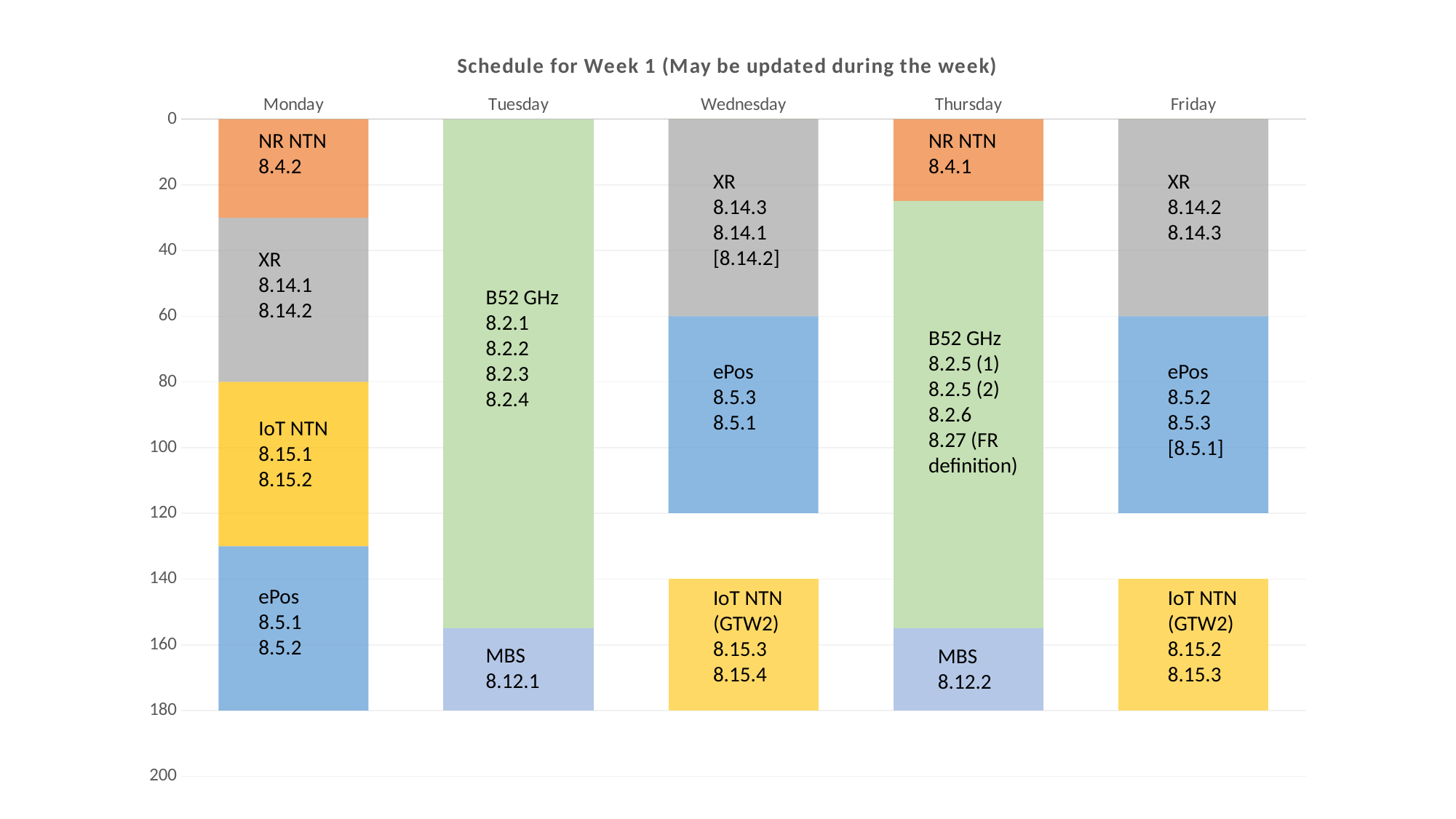
On which day is the NR NTN block labelled 8.4.1? Thursday On which day does the MBS block contain item 8.12.2? Thursday Which agenda item is listed in the NR NTN block on Monday? 8.4.2 On which days does an IoT NTN (GTW2) block appear? Wednesday and Friday What is the title of the chart? Schedule for Week 1 (May be updated during the week) Which agenda items are listed in the B52 GHz block on Tuesday? 8.2.1, 8.2.2, 8.2.3, 8.2.4 Which topic is at the top of the Tuesday bar? B52 GHz What kind of chart is shown on the slide? Stacked bar chart Which day's bar has the fewest blocks? Tuesday How many days (categories) are shown along the x axis? 5 How many blocks make up the Monday bar? 4 What colour are the ePos blocks? Blue